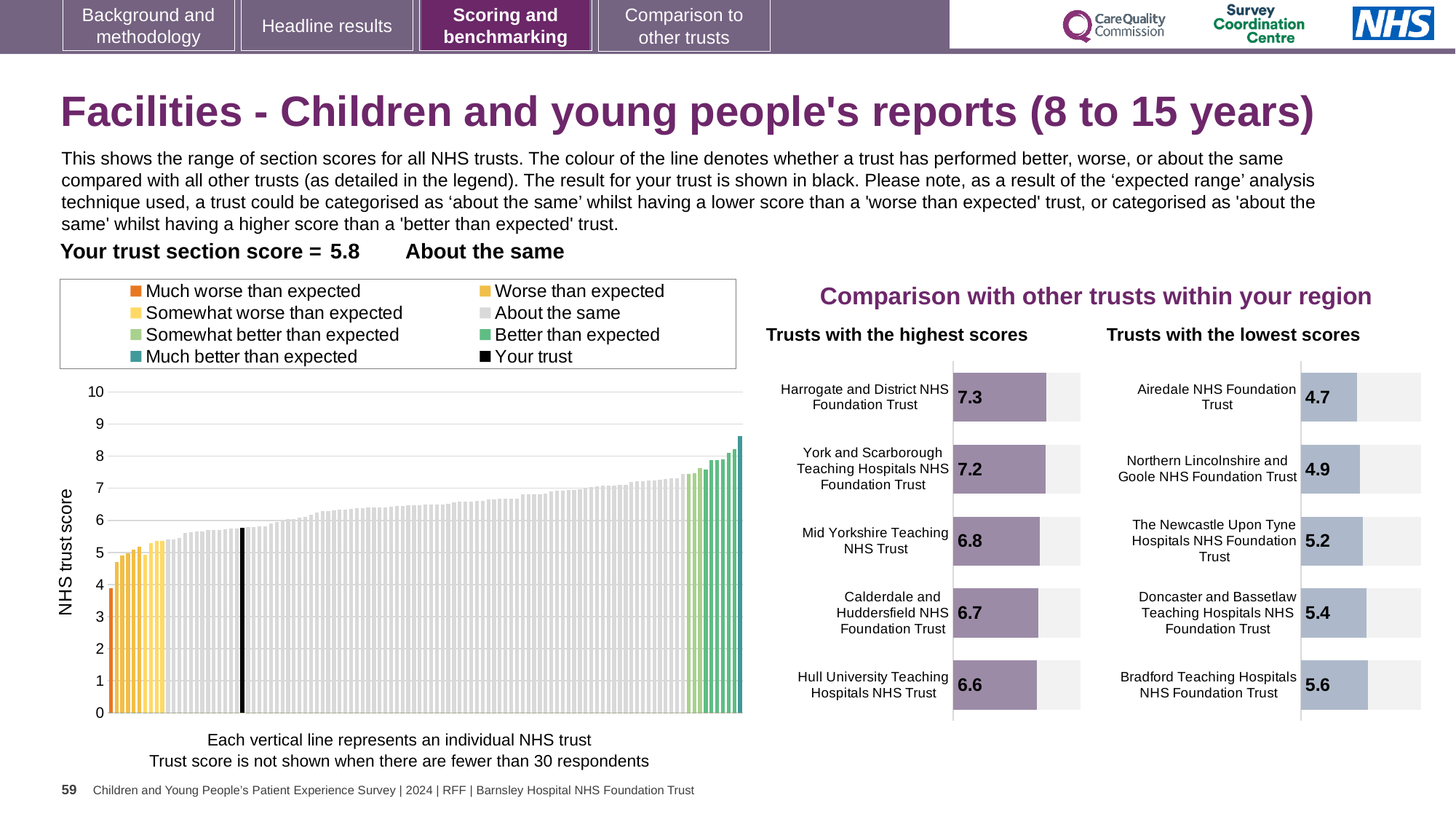
In the 'Trusts with the highest scores' chart, which trust has the lowest score? Hull University Teaching Hospitals NHS Trust In the 'Trusts with the highest scores' chart, what is the score for Mid Yorkshire Teaching NHS Trust? 6.8 In the 'Trusts with the highest scores' chart, what is the difference between the scores of Harrogate and District NHS Foundation Trust and Hull University Teaching Hospitals NHS Trust? 0.7 In the 'Trusts with the lowest scores' chart, which trust has the highest score? Bradford Teaching Hospitals NHS Foundation Trust In the 'Trusts with the lowest scores' chart, which has the larger score: The Newcastle Upon Tyne Hospitals NHS Foundation Trust or Doncaster and Bassetlaw Teaching Hospitals NHS Foundation Trust? Doncaster and Bassetlaw Teaching Hospitals NHS Foundation Trust How many entries does the legend above the large chart on the left list? 8 In the 'Trusts with the lowest scores' chart, what is the difference between the scores of Bradford Teaching Hospitals NHS Foundation Trust and Airedale NHS Foundation Trust? 0.9 In the 'Trusts with the lowest scores' chart, how many trusts are shown? 5 What kind of chart is the large chart on the left with the 'NHS trust score' axis? Bar chart In the large chart on the left showing all NHS trusts, is the value of the tallest bar greater or less than 8? greater In the 'Trusts with the lowest scores' chart, what is the score for Airedale NHS Foundation Trust? 4.7 In the 'Trusts with the highest scores' chart, what is the score for Harrogate and District NHS Foundation Trust? 7.3